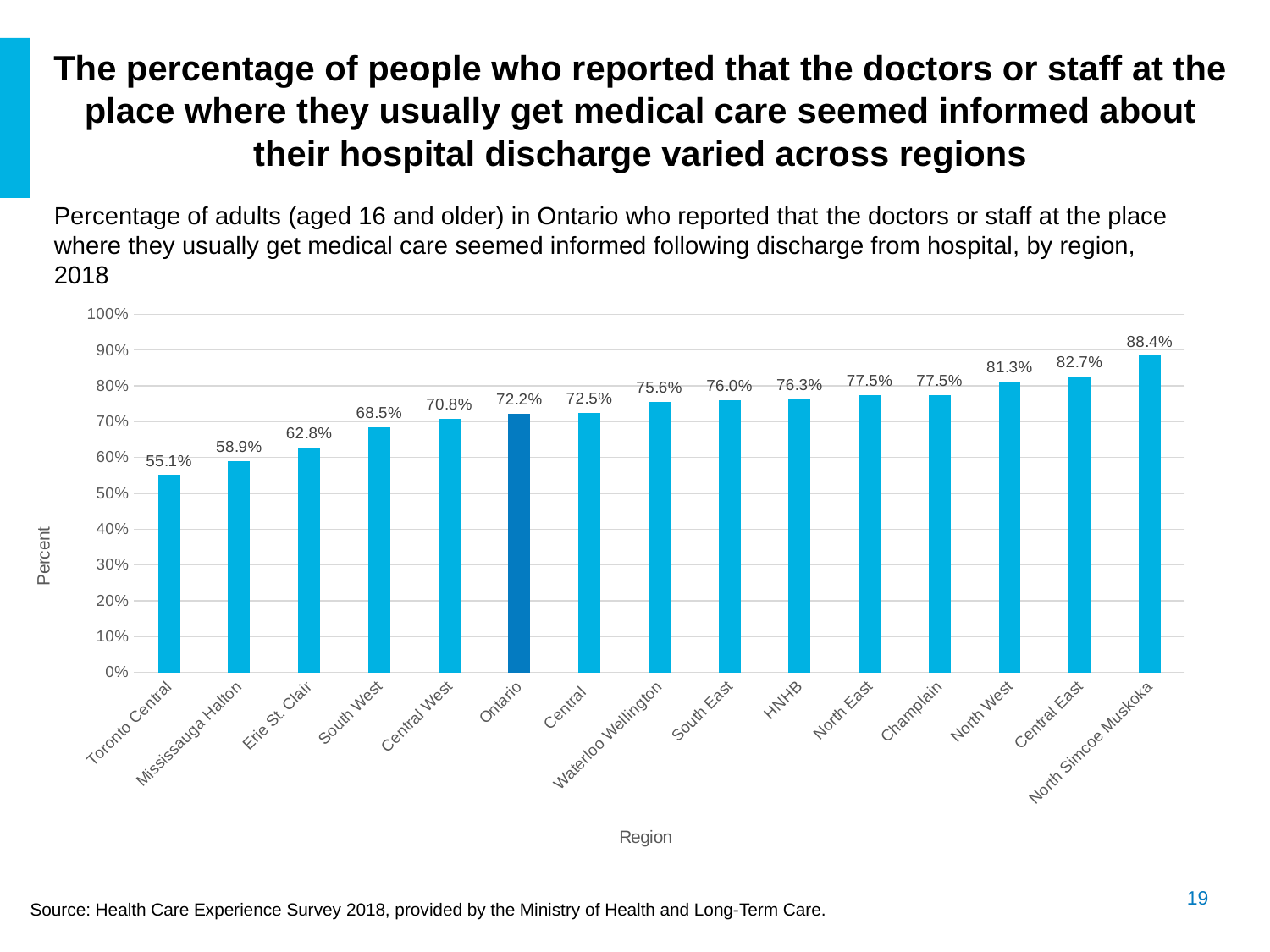
What is the value for Toronto Central? 55.1% What kind of chart is shown on the slide? bar chart Which is larger, the value for Erie St. Clair or the value for South West? South West What is the difference between the values for North Simcoe Muskoka and Toronto Central? 33.3% Which region has the lowest value? Toronto Central How many bars are shown in the chart? 15 What is the value for Ontario? 72.2% Do the values rise or fall from left to right along the x axis? rise Is the value for Mississauga Halton greater or less than 60%? less Which region has the highest value? North Simcoe Muskoka What is the value for Waterloo Wellington? 75.6% What is the difference between the values for Central East and North West? 1.4%